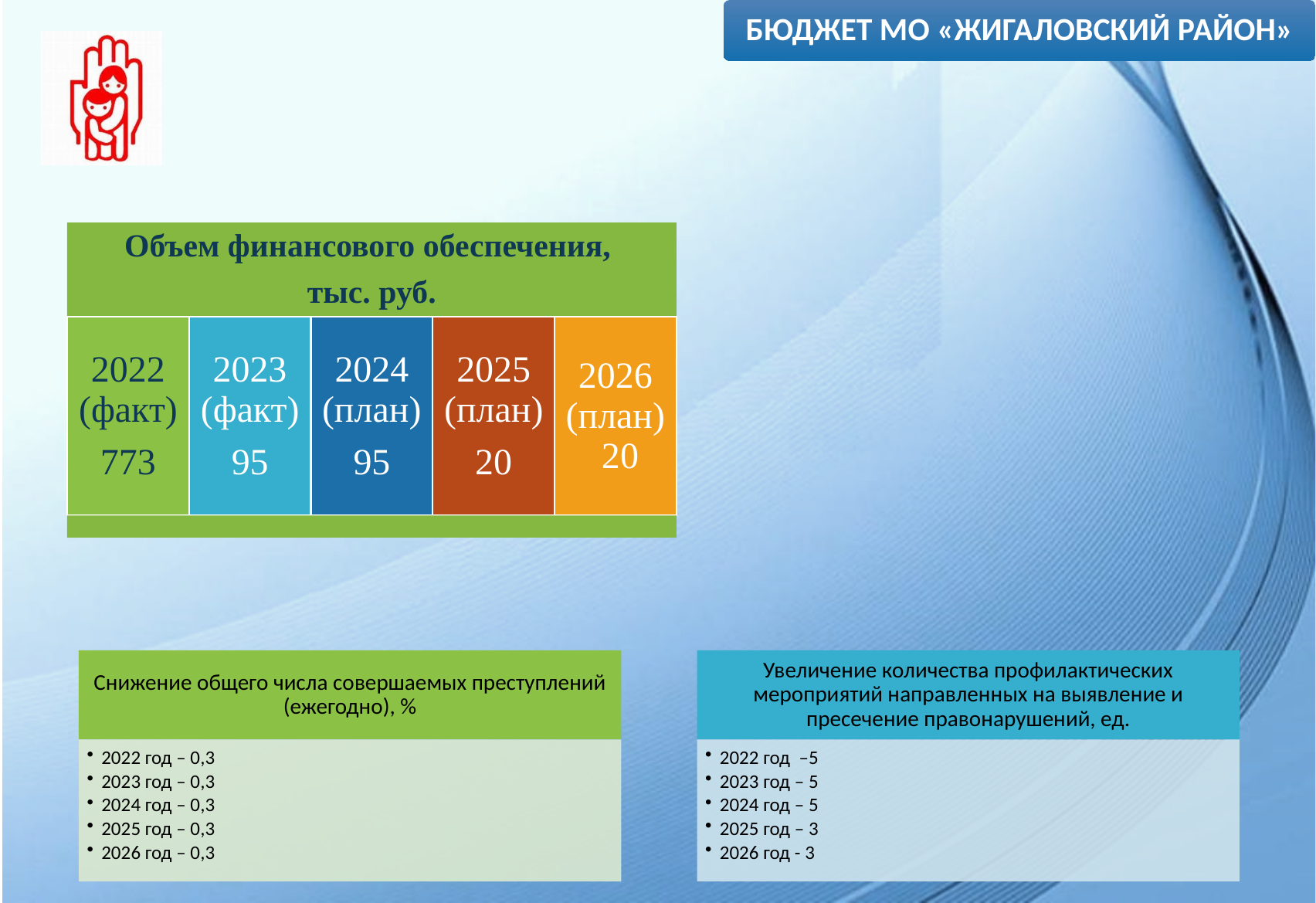
In the block titled «Объем финансового обеспечения, тыс. руб.», what is the difference between the 2022 (факт) value and the 2023 (факт) value? 678 In the block titled «Объем финансового обеспечения, тыс. руб.», which year has the highest value? 2022 (факт) In the block titled «Объем финансового обеспечения, тыс. руб.», do the values rise or fall from 2022 to 2026? fall In the block titled «Объем финансового обеспечения, тыс. руб.», what is the value for 2022 (факт)? 773 In the block titled «Объем финансового обеспечения, тыс. руб.», what is the value for 2023 (факт)? 95 In the block titled «Объем финансового обеспечения, тыс. руб.», what unit is stated in the title? тыс. руб. In the block titled «Объем финансового обеспечения, тыс. руб.», what is the value for 2025 (план)? 20 In the block titled «Объем финансового обеспечения, тыс. руб.», what is the difference between the 2024 (план) value and the 2026 (план) value? 75 In the block titled «Объем финансового обеспечения, тыс. руб.», what colour is the 2026 (план) cell? orange In the block titled «Объем финансового обеспечения, тыс. руб.», what is the total of the values for 2025 (план) and 2026 (план)? 40 How many years are shown in the block titled «Объем финансового обеспечения, тыс. руб.»? 5 In the block titled «Объем финансового обеспечения, тыс. руб.», which is larger: the value for 2023 (факт) or the value for 2025 (план)? 2023 (факт)